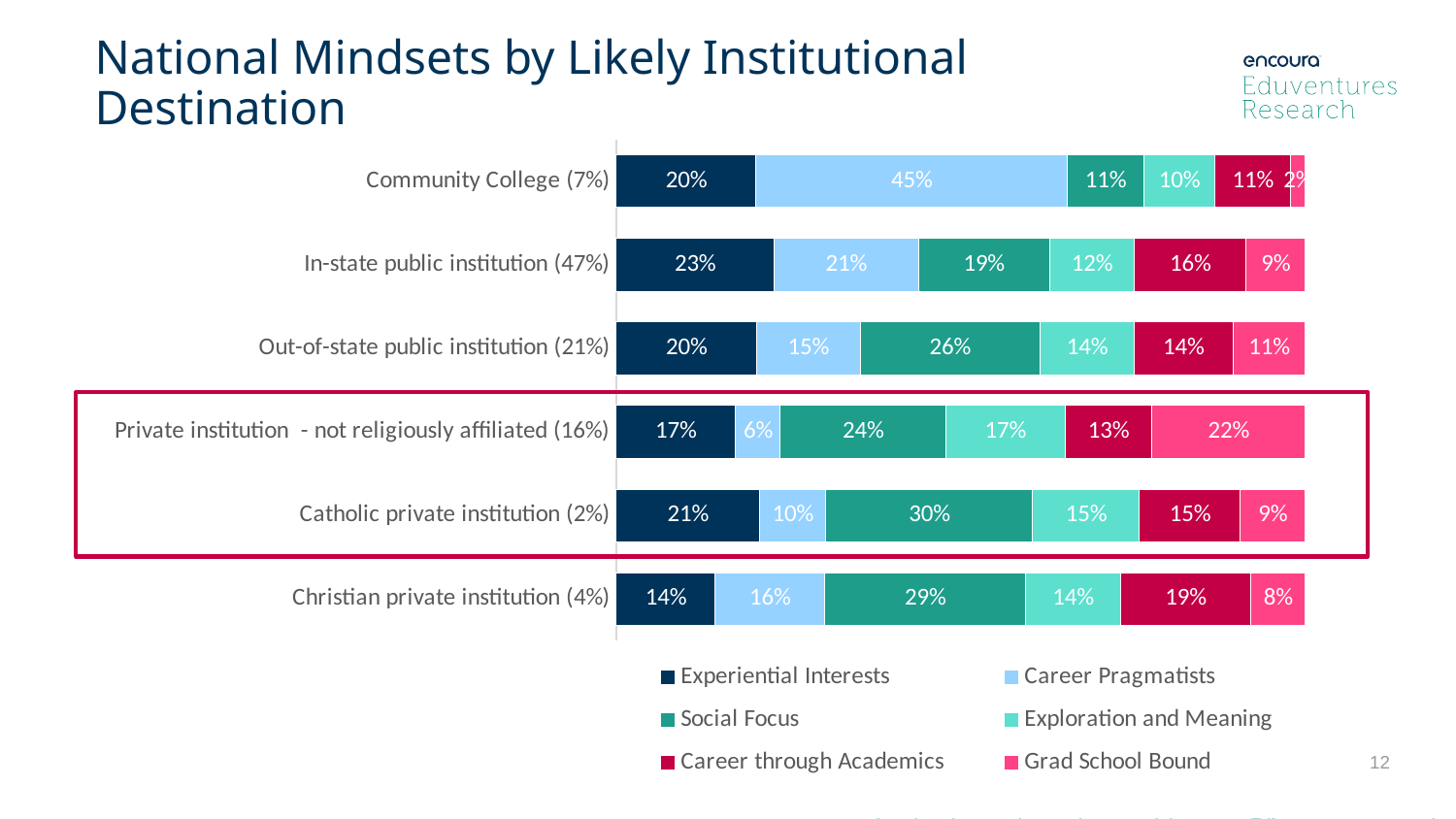
How many series does the legend list? 6 Which is larger: the Career through Academics value for Christian private institution or for Out-of-state public institution? Christian private institution Which institutional destination has the lowest Career Pragmatists share? Private institution - not religiously affiliated (16%) What is the Grad School Bound value for Private institution - not religiously affiliated? 22% What is the Social Focus value for Catholic private institution? 30% What percentage of Community College students are Career Pragmatists? 45% Which legend entry is shown in dark navy? Experiential Interests What is the Experiential Interests value for Christian private institution? 14% What kind of chart is shown on the slide? Stacked bar chart What is the difference between the Social Focus values for Catholic private institution and In-state public institution? 11% How many institutional destination categories are shown in the chart? 6 Which institutional destination has the highest Career Pragmatists share? Community College (7%)